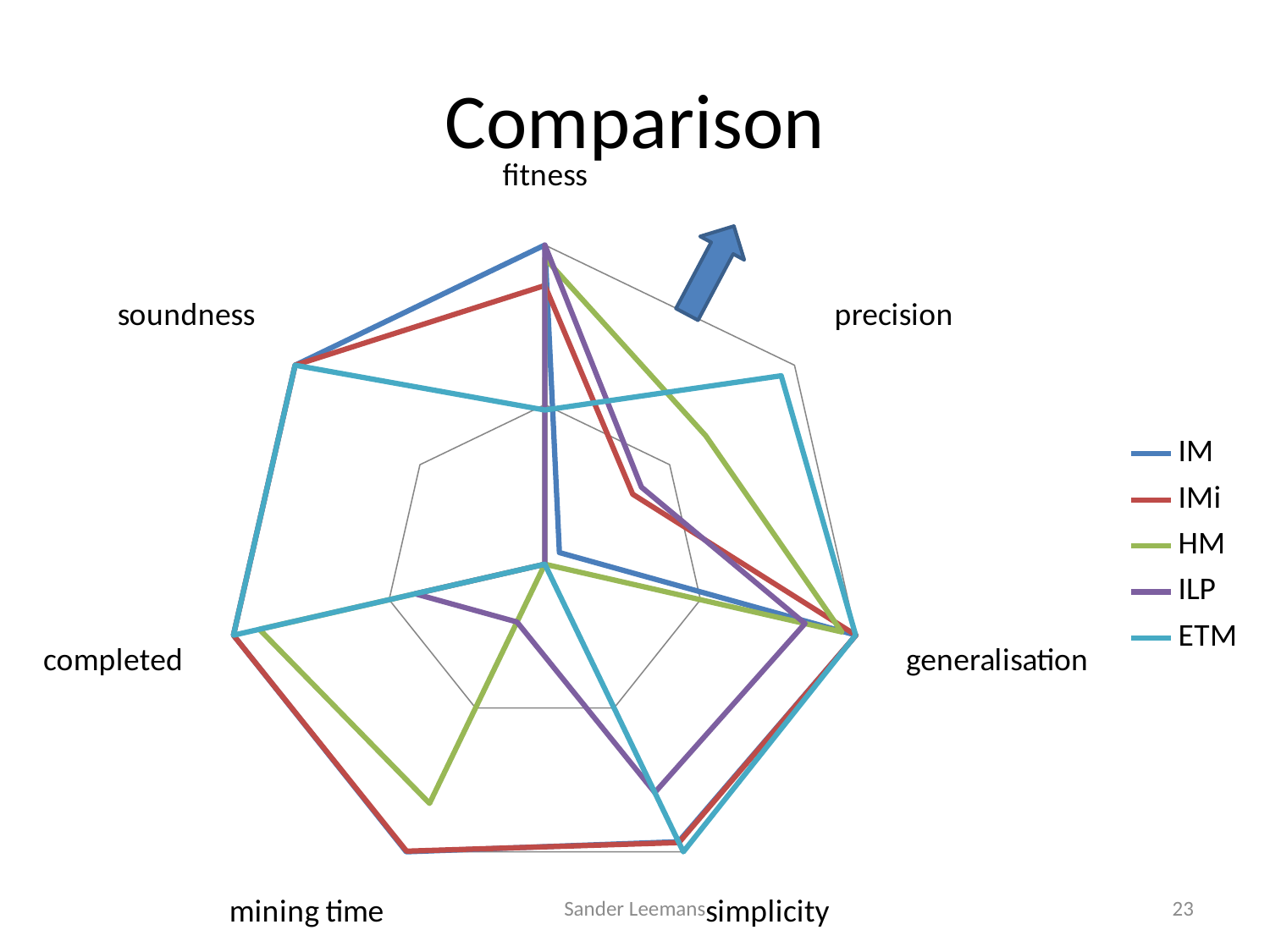
Which series has the lowest value on the fitness axis? ETM How many series does the legend list? 5 Which series has the highest value on the precision axis? ETM What kind of chart is shown on the slide? radar chart On the precision axis, which is larger: ETM or IM? ETM Which series are listed in the legend? IM, IMi, HM, ILP, ETM What is the title of the chart? Comparison On the mining time axis, which is larger: IMi or HM? IMi On the fitness axis, which is larger: IM or ETM? IM How many axes (categories) does the radar chart have? 7